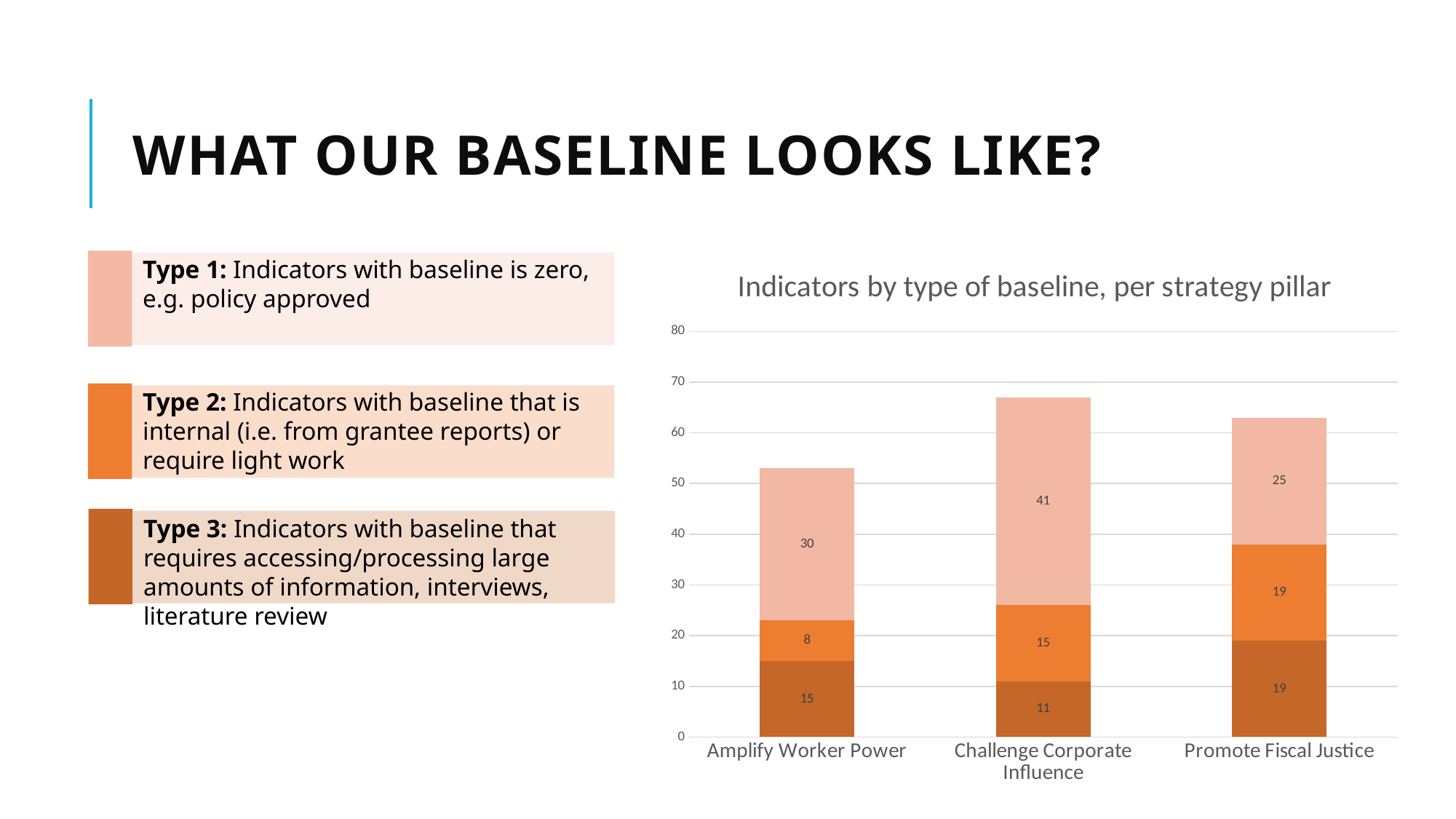
What is the difference between the Type 1 value for Challenge Corporate Influence and the Type 1 value for Amplify Worker Power? 11 What kind of chart is shown on the slide? Stacked bar chart Which is larger: the Type 2 value for Promote Fiscal Justice or the Type 2 value for Challenge Corporate Influence? Promote Fiscal Justice Which strategy pillar has the highest Type 1 value (lightest segment)? Challenge Corporate Influence What is the total of the stacked bar for Challenge Corporate Influence? 67 How many strategy pillars (categories) are shown on the x axis of the chart? 3 What is the Type 1 value (lightest segment) for Challenge Corporate Influence? 41 What is the title of the chart? Indicators by type of baseline, per strategy pillar What is the Type 3 value (darkest segment) for Promote Fiscal Justice? 19 What is the total of the stacked bar for Amplify Worker Power? 53 Which strategy pillar has the lowest Type 3 value (darkest segment)? Challenge Corporate Influence What is the Type 2 value (orange segment) for Amplify Worker Power? 8